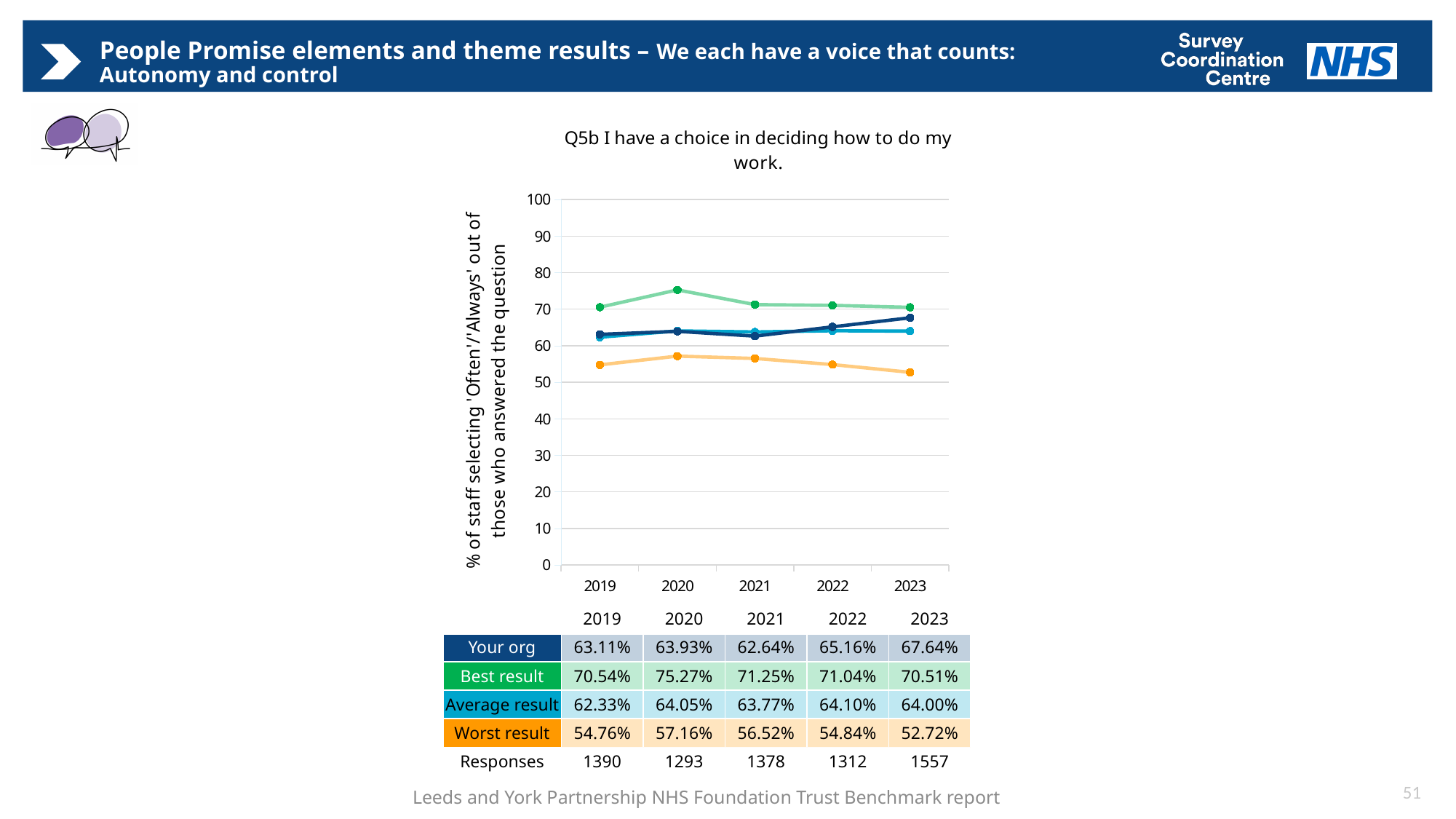
What is the 'Average result' value for 2022? 64.10% How many series are plotted on the chart? 4 What kind of chart is shown? Line chart What is the 'Worst result' value for 2021? 56.52% In which year is the 'Your org' value highest? 2023 In which year is the 'Worst result' value lowest? 2023 What is the 'Best result' value for 2020? 75.27% Which is larger in 2021: the 'Your org' value or the 'Average result' value? Average result What is the difference between the 'Best result' and 'Your org' values in 2019? 7.43% Is the 'Best result' value for 2020 greater or less than 70? greater What is the 'Your org' value for 2023? 67.64% How many years are plotted on the x axis? 5